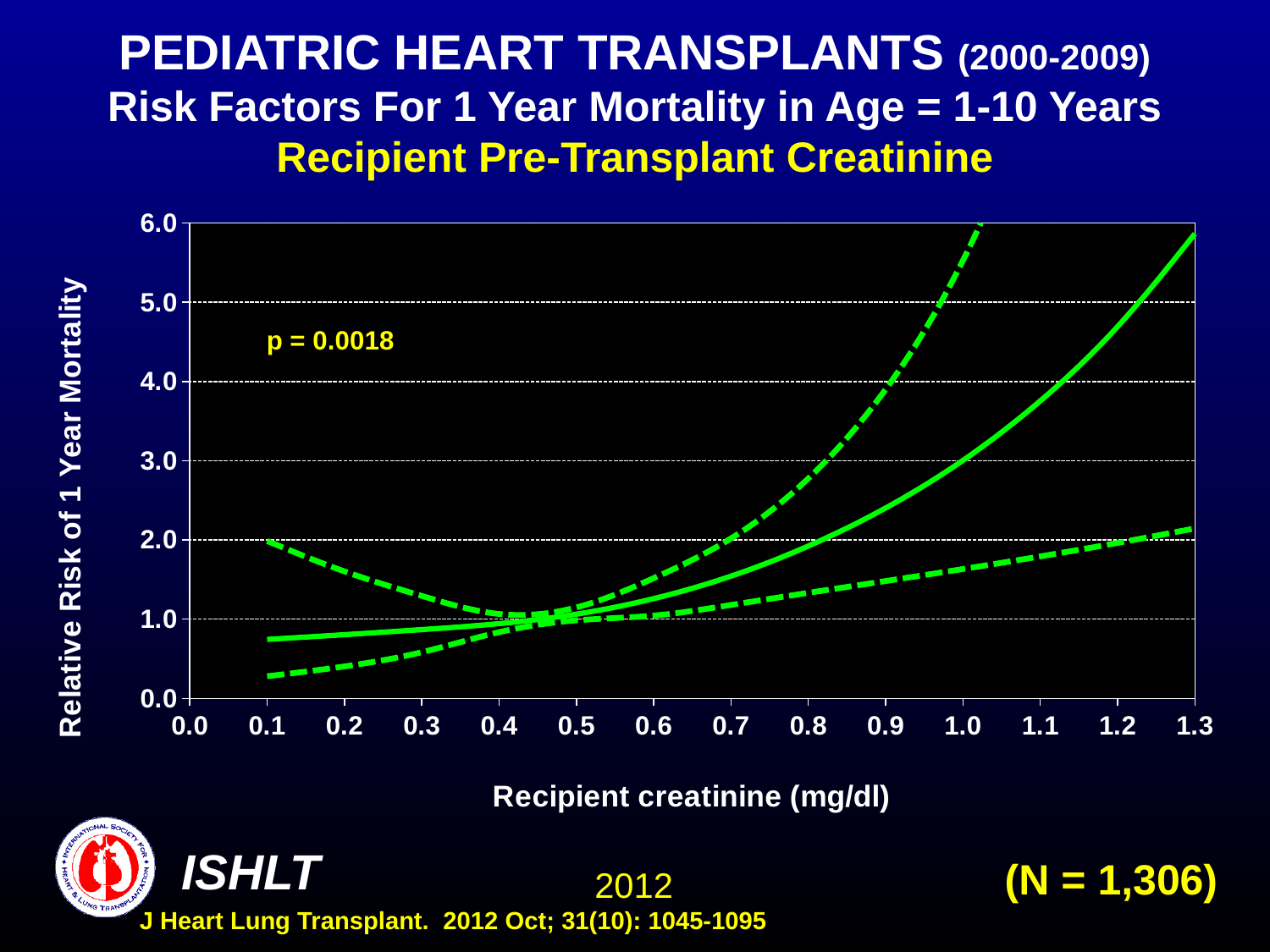
Is the value of the solid relative risk line at a recipient creatinine of 0.1 mg/dl greater or less than 1.0? less Is the value of the lower dashed line at a recipient creatinine of 1.0 mg/dl greater or less than 2.0? less What is the p-value shown on the chart? p = 0.0018 What is the label of the x axis? Recipient creatinine (mg/dl) What is the highest value shown on the y axis? 6.0 Does the solid line for relative risk rise or fall as recipient creatinine increases from 0.1 to 1.3 mg/dl? rise Is the value of the upper dashed line at a recipient creatinine of 0.2 mg/dl greater or less than 2.0? less What is the highest value shown on the x axis? 1.3 What kind of chart is shown on the slide? line chart How many lines are plotted on the chart? 3